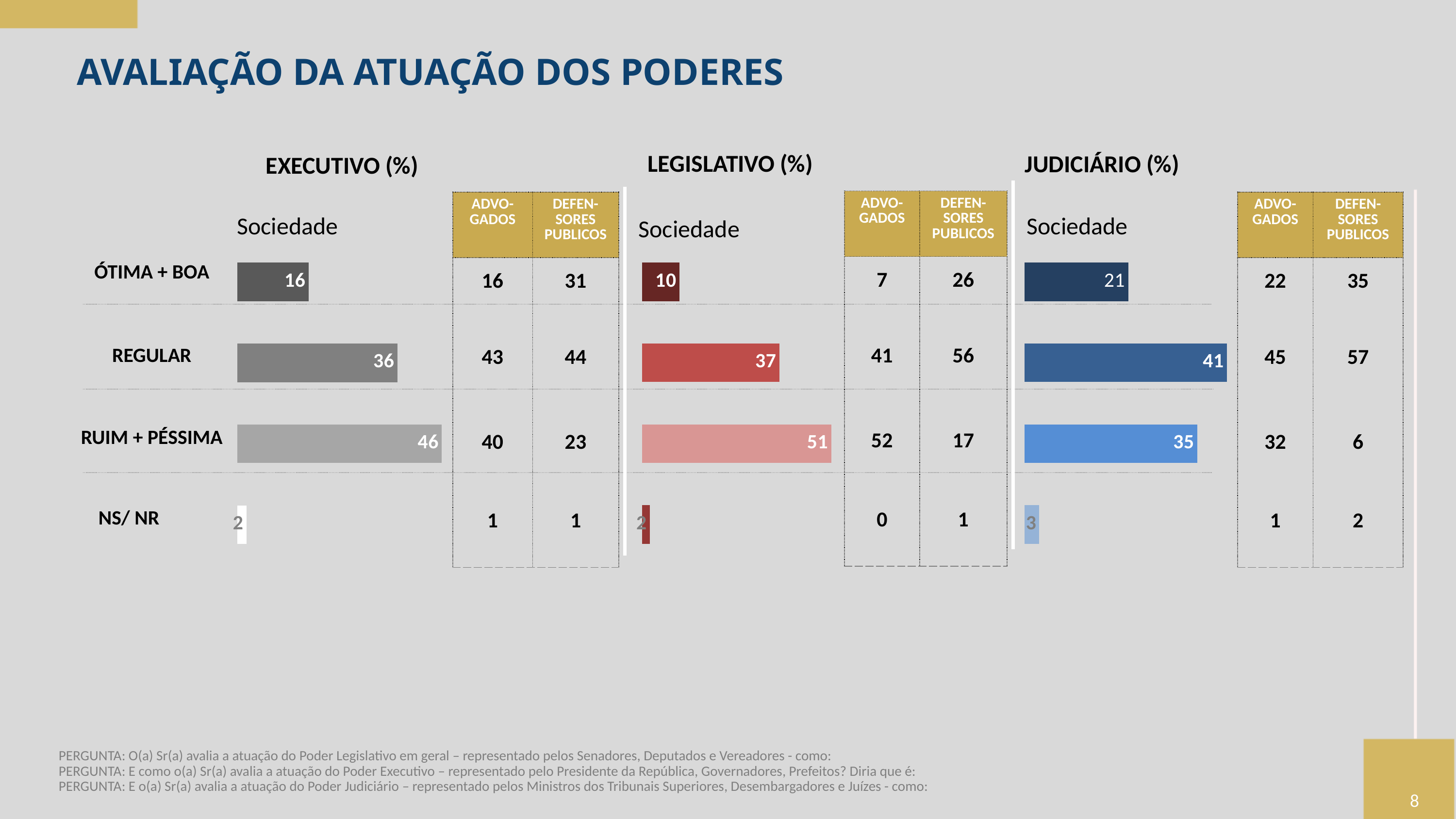
In the EXECUTIVO (%) chart, what is the difference between the Sociedade values for RUIM + PÉSSIMA and ÓTIMA + BOA? 30 In the JUDICIÁRIO (%) chart, which Sociedade value is larger: REGULAR or RUIM + PÉSSIMA? REGULAR In the JUDICIÁRIO (%) chart, what is the difference between the Sociedade values for REGULAR and RUIM + PÉSSIMA? 6 In the LEGISLATIVO (%) chart, which category has the highest Sociedade value? RUIM + PÉSSIMA In the EXECUTIVO (%) chart, what is the Sociedade value for RUIM + PÉSSIMA? 46 What type of chart is used for the Sociedade data in the EXECUTIVO (%) chart? Bar chart Which chart has the larger Sociedade value for ÓTIMA + BOA: EXECUTIVO (%) or LEGISLATIVO (%)? EXECUTIVO (%) In the LEGISLATIVO (%) chart, what is the Sociedade value for REGULAR? 37 In the JUDICIÁRIO (%) chart, what is the Sociedade value for NS/ NR? 3 In the JUDICIÁRIO (%) chart, which category has the lowest Sociedade value? NS/ NR How many categories are shown in the LEGISLATIVO (%) chart? 4 In the JUDICIÁRIO (%) chart, what is the Sociedade value for ÓTIMA + BOA? 21